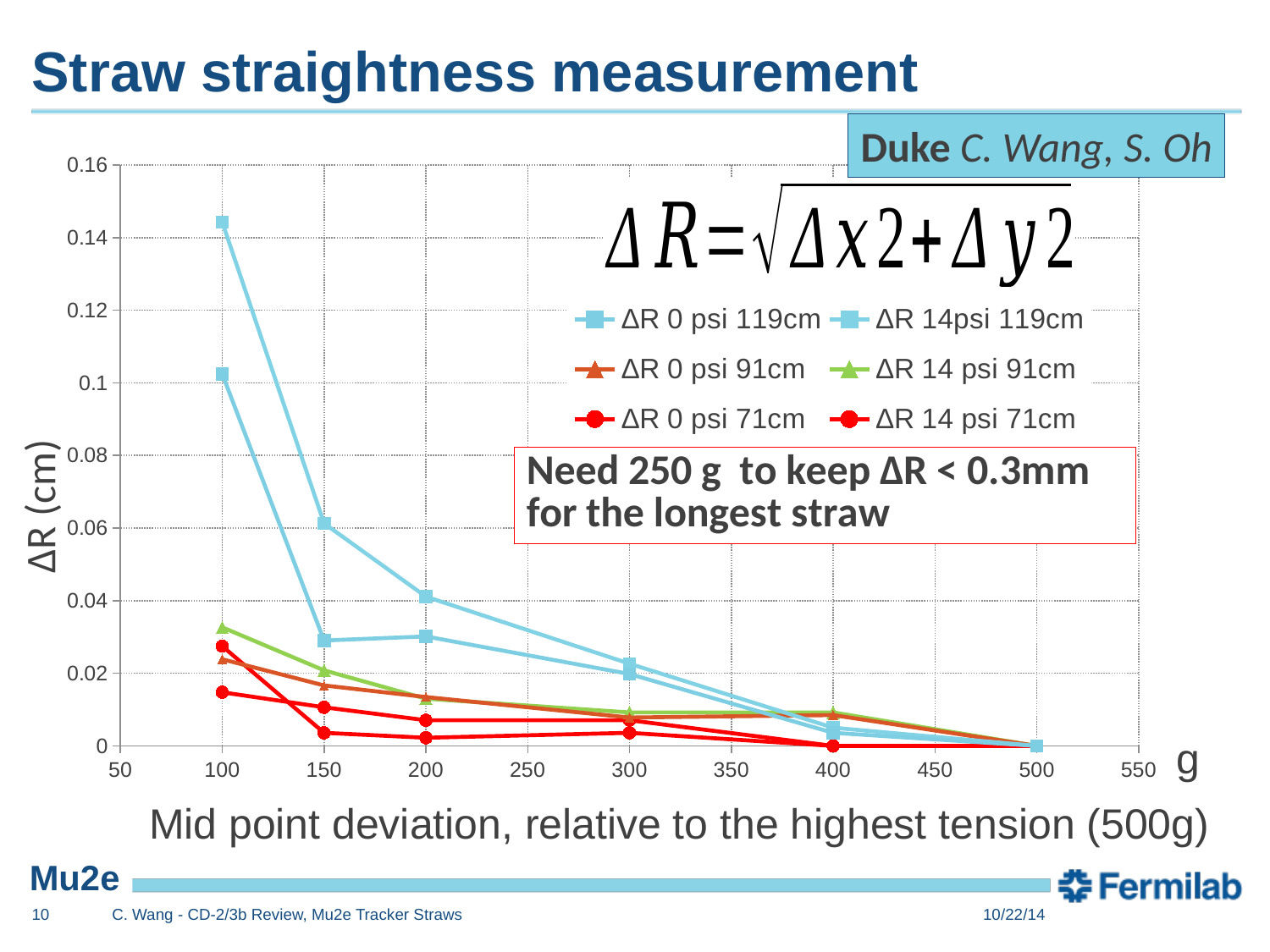
At which tension value is the highest ΔR on the chart plotted? 100 What kind of chart is shown on the slide? line chart What is the label on the y axis? ΔR (cm) What is the ΔR value of all series at 500 g? 0 Is the value for ΔR 14 psi 91cm at 100 g greater or less than 0.02? greater Is the value for ΔR 0 psi 91cm at 200 g greater or less than 0.02? less How many tension values (x-axis points) are plotted for each series? 6 At 100 g, which is higher: ΔR 14 psi 91cm or ΔR 0 psi 91cm? ΔR 14 psi 91cm How many series does the legend list? 6 Is the highest ΔR value plotted at 100 g greater or less than 0.12? greater What unit is shown at the end of the x axis? g Do the ΔR values rise or fall as the tension increases along the x axis? fall